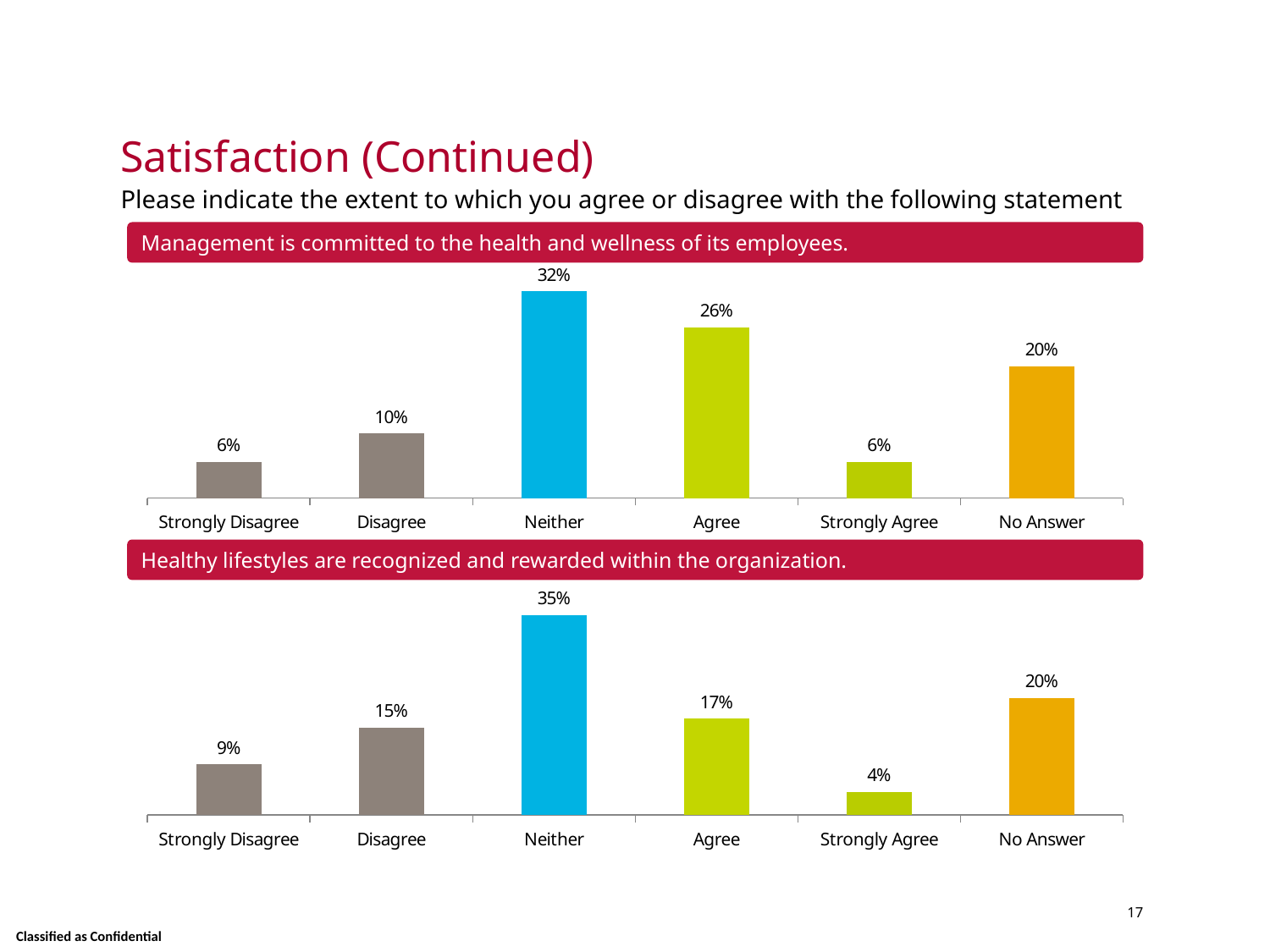
In the top chart, which is larger, the value for Agree or the value for No Answer? Agree In the chart titled 'Management is committed to the health and wellness of its employees.', what is the value for Neither? 32% How many categories are shown in the top chart? 6 In the top chart, what is the difference between the values for Neither and Agree? 6% In the bottom chart, what is the difference between the values for Disagree and Strongly Disagree? 6% In the top chart, which category has the highest value? Neither In the bottom chart, which category has the lowest value? Strongly Agree In the top chart, what is the value for Strongly Disagree? 6% In the bottom chart, what is the value for No Answer? 20% In the chart titled 'Healthy lifestyles are recognized and rewarded within the organization.', what is the value for Agree? 17% In the bottom chart, which is larger, the value for Disagree or the value for Agree? Agree What kind of chart is the bottom chart? Bar chart